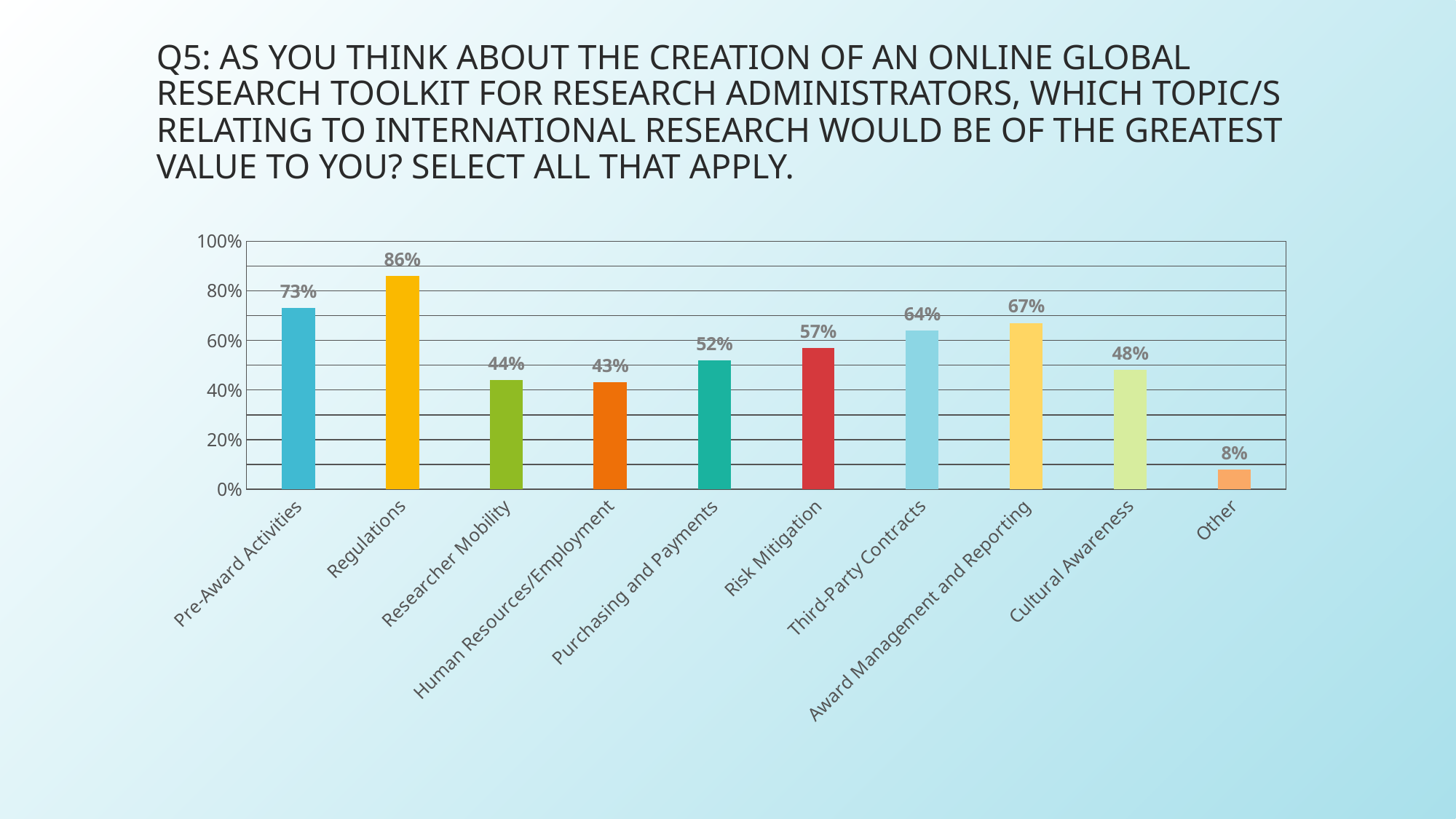
What is the difference between the values for Researcher Mobility and Human Resources/Employment? 1% What kind of chart is shown on the slide? bar chart Which is larger, the value for Third-Party Contracts or the value for Purchasing and Payments? Third-Party Contracts Which category has the highest value? Regulations What is the value for Risk Mitigation? 57% Which category has the lowest value? Other How many categories are shown on the chart? 10 Is the value for Cultural Awareness greater or less than 60%? less What is the value for Award Management and Reporting? 67% What is the maximum value shown on the vertical axis? 100% What is the value for Regulations? 86% What is the difference between the values for Regulations and Pre-Award Activities? 13%